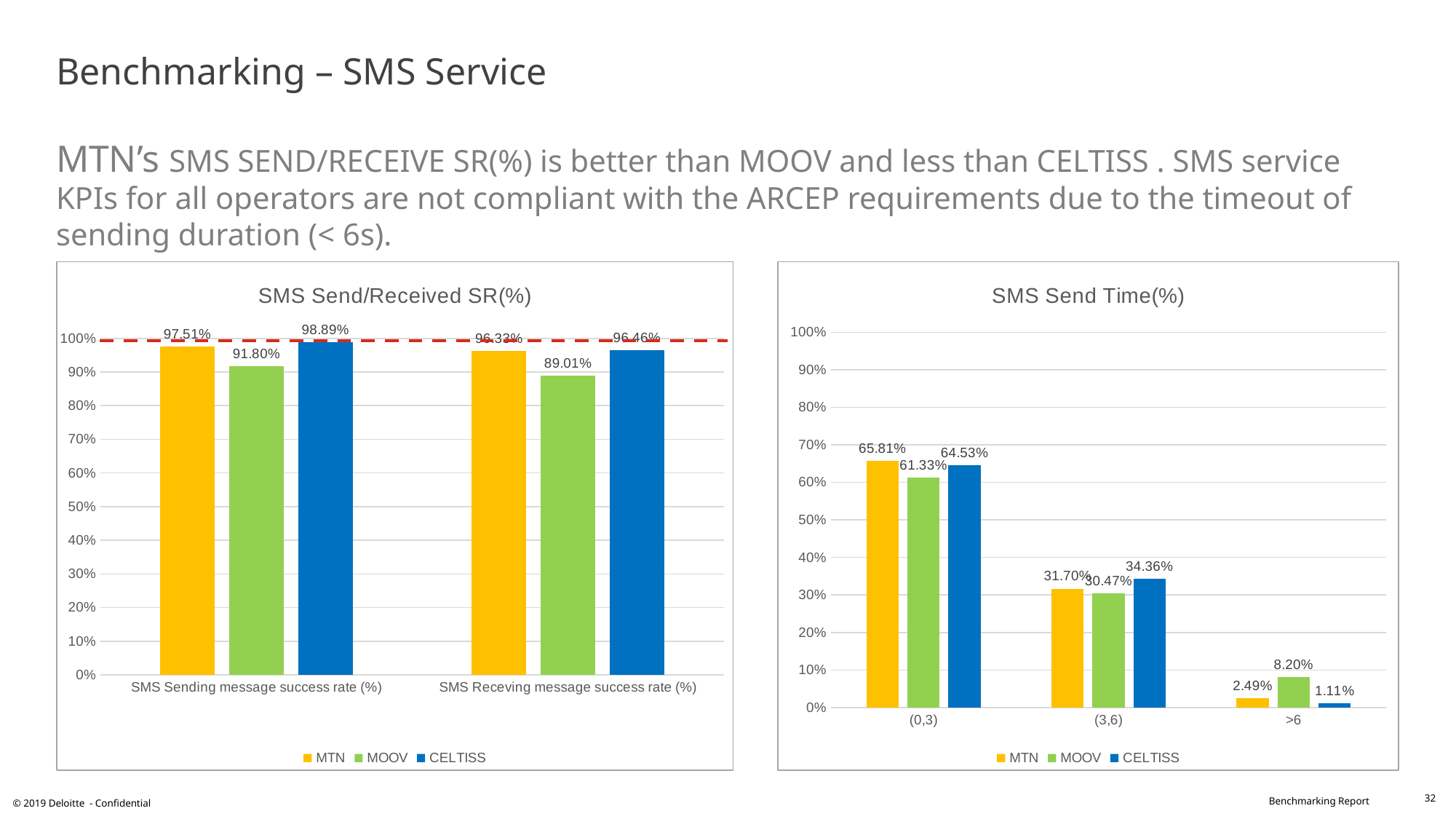
What type of chart is the SMS Send Time(%) chart? Bar chart In the SMS Send/Received SR(%) chart, what is the difference between CELTISS and MTN for SMS Sending message success rate (%)? 1.38% In the SMS Send Time(%) chart, which is larger for the (0,3) category: MTN or MOOV? MTN In the SMS Send/Received SR(%) chart, what is the value for CELTISS for SMS Sending message success rate (%)? 98.89% In the SMS Send/Received SR(%) chart, what is the value for MOOV for SMS Sending message success rate (%)? 91.80% In the SMS Send Time(%) chart, which operator has the highest value in the >6 category? MOOV In the SMS Send/Received SR(%) chart, how many series does the legend list? 3 In the SMS Send Time(%) chart, what is the value for CELTISS in the (3,6) category? 34.36% In the SMS Send Time(%) chart, how many categories are shown on the x axis? 3 In the SMS Send Time(%) chart, what is the difference between MOOV and CELTISS in the >6 category? 7.09% In the SMS Send Time(%) chart, what is the value for MTN in the (0,3) category? 65.81% In the SMS Send/Received SR(%) chart, which operator has the lowest SMS Receving message success rate (%)? MOOV